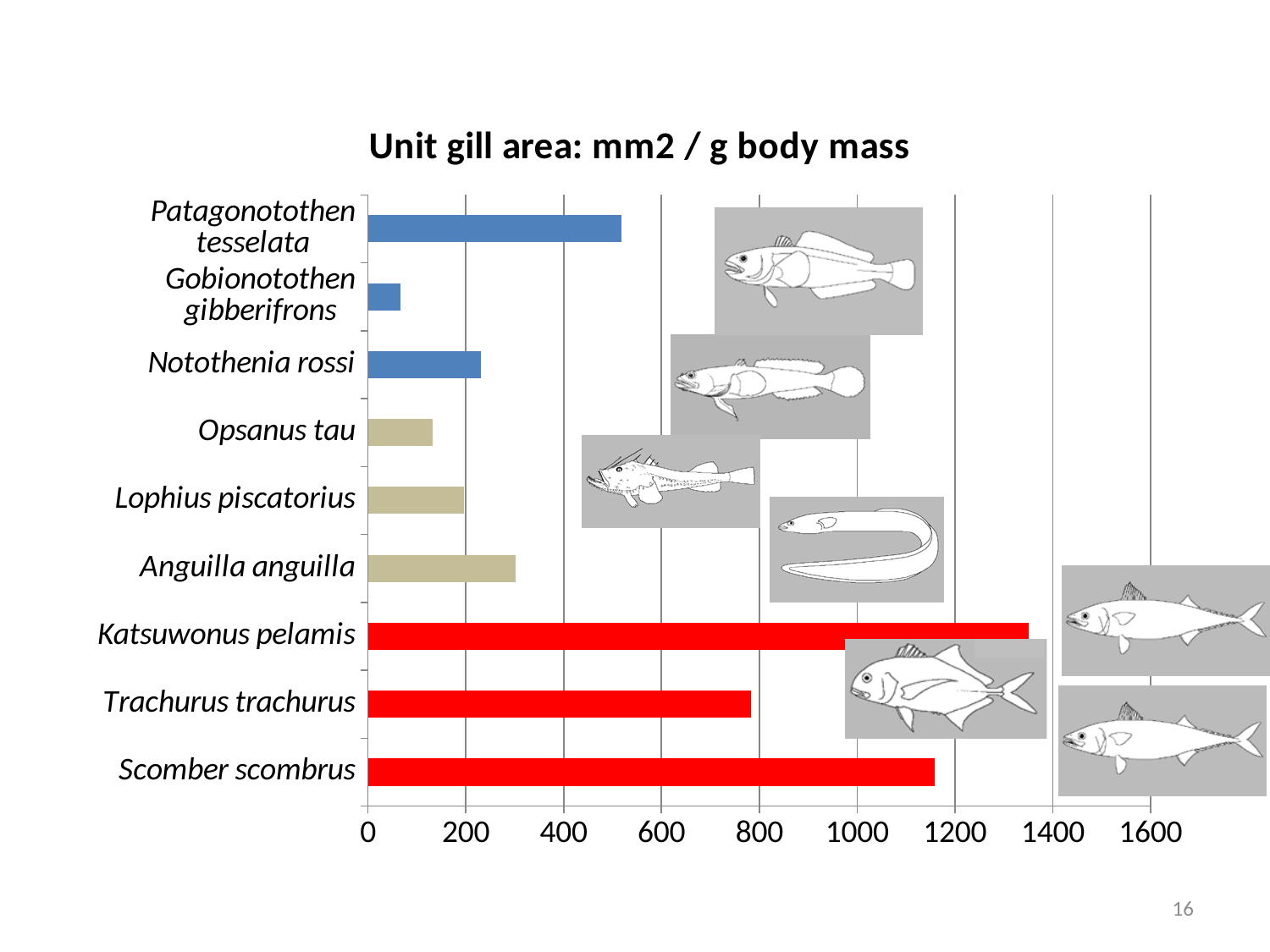
What colour are the bars for Katsuwonus pelamis, Trachurus trachurus and Scomber scombrus? red Is the value for Patagonotothen tesselata greater or less than 400? greater How many fish species are plotted in the chart? 9 What is the title of the chart? Unit gill area: mm2 / g body mass Which has a larger unit gill area, Anguilla anguilla or Opsanus tau? Anguilla anguilla Which has a larger unit gill area, Patagonotothen tesselata or Notothenia rossi? Patagonotothen tesselata What kind of chart is shown on the slide? bar chart Which species has the highest unit gill area? Katsuwonus pelamis Is the value for Trachurus trachurus greater or less than 800? less Which species has the lowest unit gill area? Gobionotothen gibberifrons Which has a larger unit gill area, Scomber scombrus or Trachurus trachurus? Scomber scombrus Is the value for Katsuwonus pelamis greater or less than 1200? greater